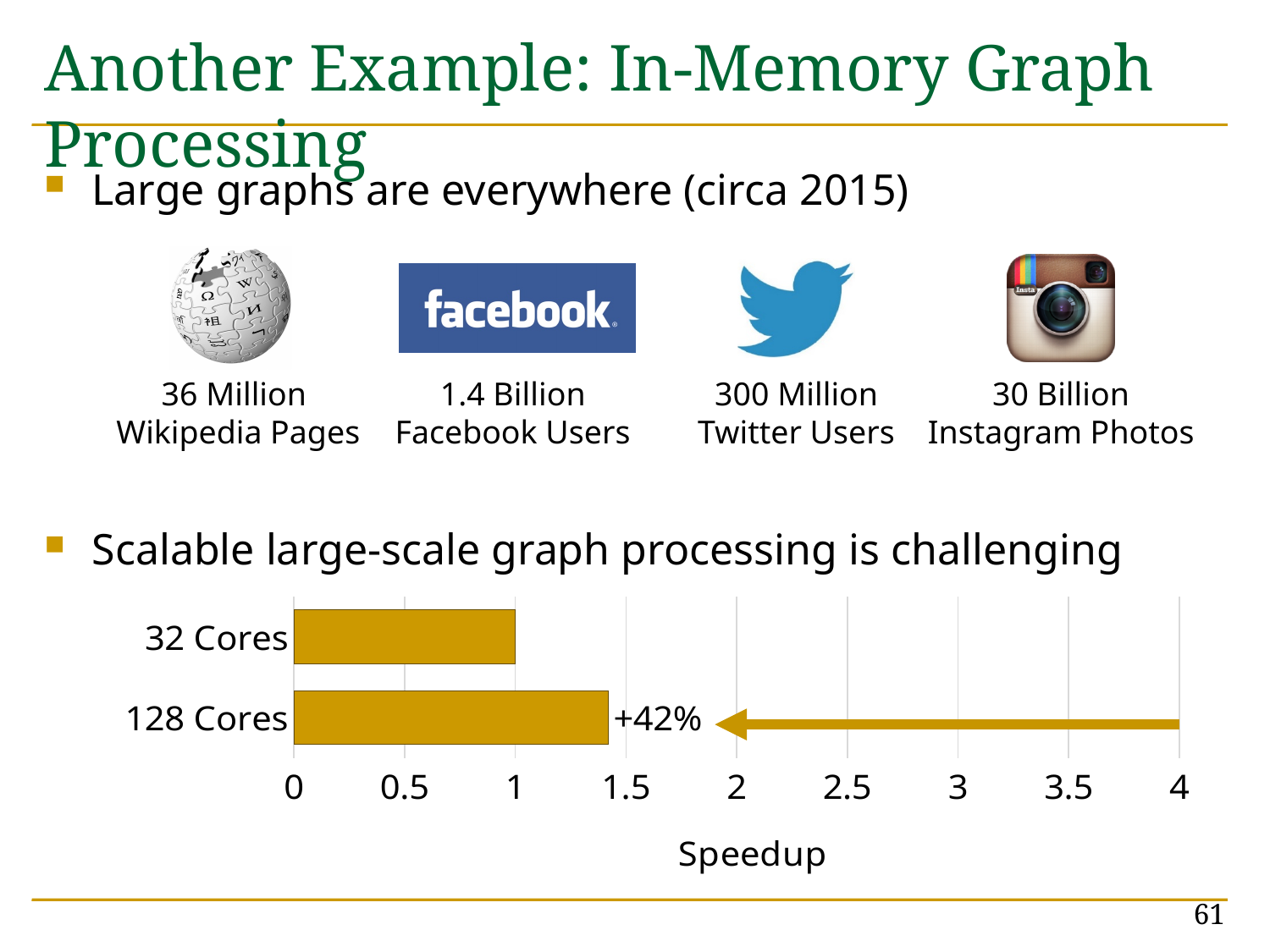
Which category has the highest speedup? 128 Cores Which has a larger speedup, 32 Cores or 128 Cores? 128 Cores What is the maximum value shown on the x axis of the chart? 4 Which category has the lowest speedup? 32 Cores Is the speedup for 128 Cores greater or less than 1.5? less Is the speedup for 128 Cores greater or less than 1? greater What kind of chart is shown on the slide? bar chart What percentage improvement is annotated next to the 128 Cores bar? +42% Is the speedup for 128 Cores greater or less than 2? less What is the label of the x axis of the chart? Speedup How many categories does the bar chart show? 2 What is the speedup value for 32 Cores? 1